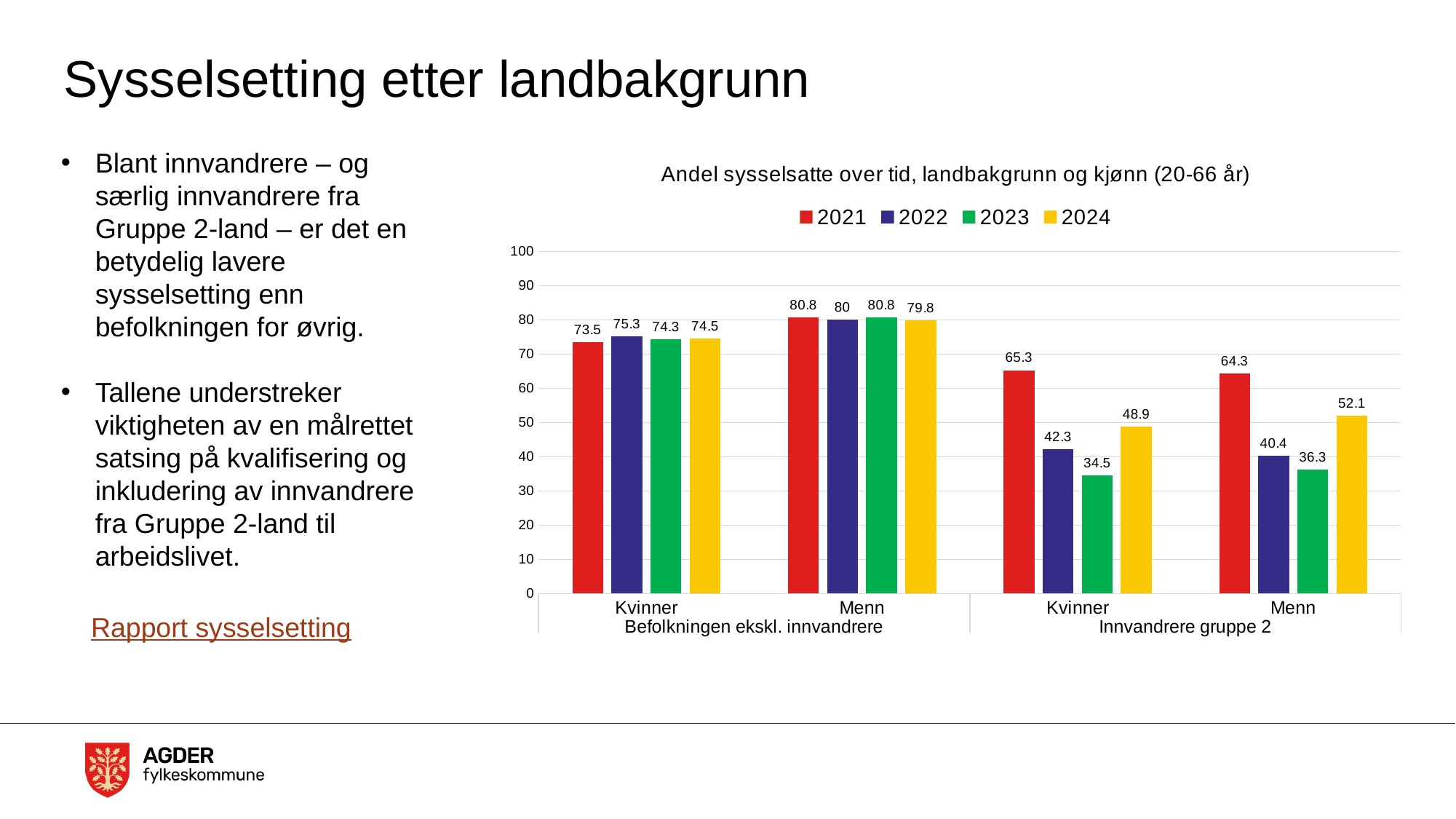
Which is larger: the 2024 value for Menn in Innvandrere gruppe 2 or the 2024 value for Kvinner in Innvandrere gruppe 2? Menn in Innvandrere gruppe 2 What is the 2023 value for Kvinner in the Innvandrere gruppe 2 group? 34.5 What kind of chart is shown on the slide? Bar chart Which colour represents the 2024 series in the chart? Yellow What is the difference between the 2021 and 2023 values for Kvinner in the Innvandrere gruppe 2 group? 30.8 What is the 2024 value for Kvinner in the Innvandrere gruppe 2 group? 48.9 Is the 2022 value for Menn in the Innvandrere gruppe 2 group greater or less than 50? less How many series does the legend list? 4 Which year has the highest value for Menn in the Innvandrere gruppe 2 group? 2021 What is the 2021 value for Menn in the Befolkningen ekskl. innvandrere group? 80.8 Which year has the lowest value for Kvinner in the Befolkningen ekskl. innvandrere group? 2021 What is the title of the chart? Andel sysselsatte over tid, landbakgrunn og kjønn (20-66 år)